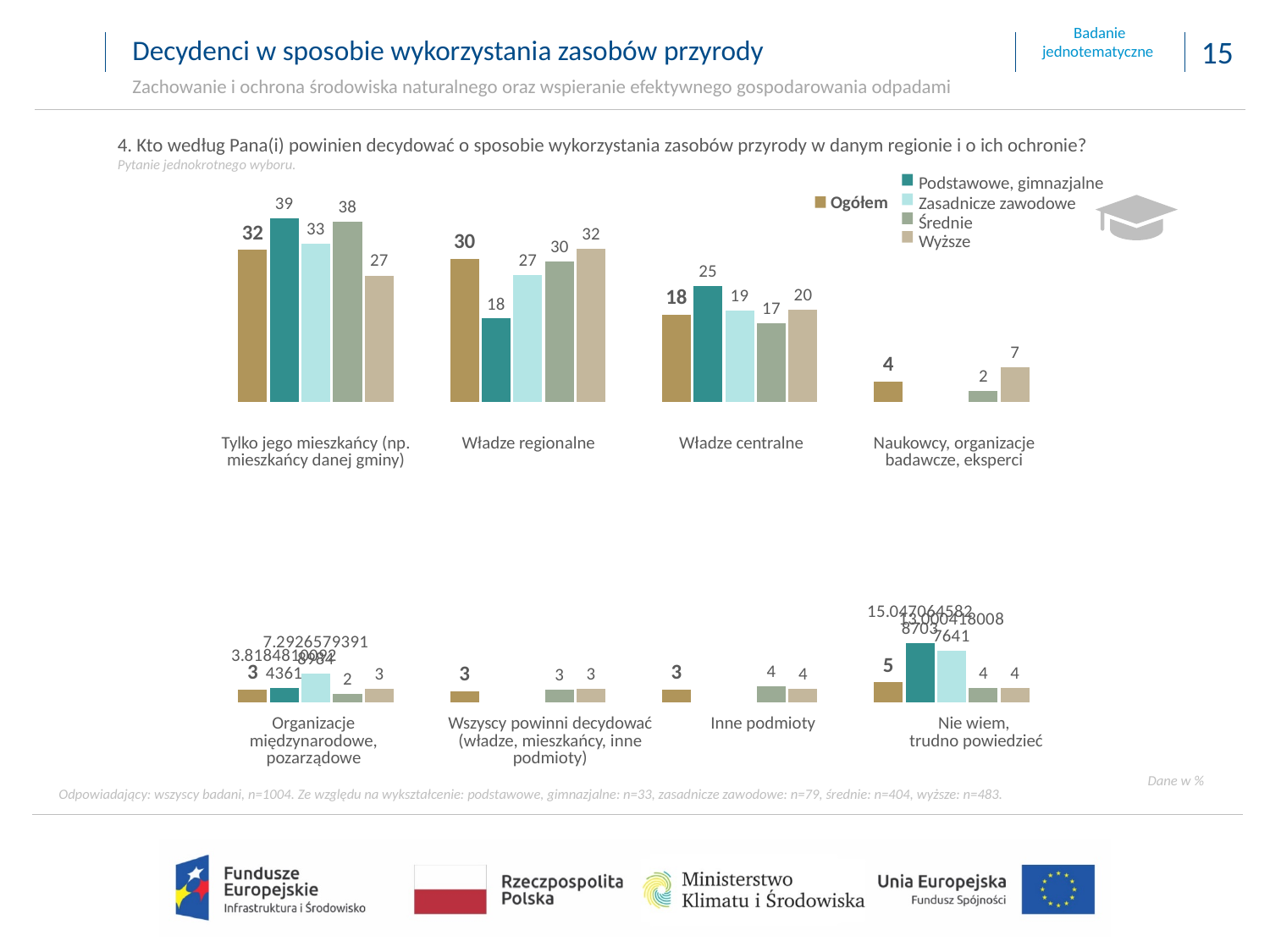
What is the Podstawowe, gimnazjalne value for "Władze centralne"? 25 For "Władze centralne", which is larger: the Zasadnicze zawodowe value or the Średnie value? Zasadnicze zawodowe Which education group has the lowest value for "Władze regionalne"? Podstawowe, gimnazjalne Which education group has the highest value for "Tylko jego mieszkańcy (np. mieszkańcy danej gminy)"? Podstawowe, gimnazjalne What is the Ogółem value for "Tylko jego mieszkańcy (np. mieszkańcy danej gminy)"? 32 What is the Ogółem value for "Naukowcy, organizacje badawcze, eksperci"? 4 How many series does the legend list? 5 What is the Ogółem value for "Nie wiem, trudno powiedzieć"? 5 What is the difference between the Podstawowe, gimnazjalne and Wyższe values for "Tylko jego mieszkańcy (np. mieszkańcy danej gminy)"? 12 What is the Wyższe value for "Inne podmioty"? 4 What is the Wyższe value for "Władze regionalne"? 32 What kind of chart is shown on the slide? Bar chart